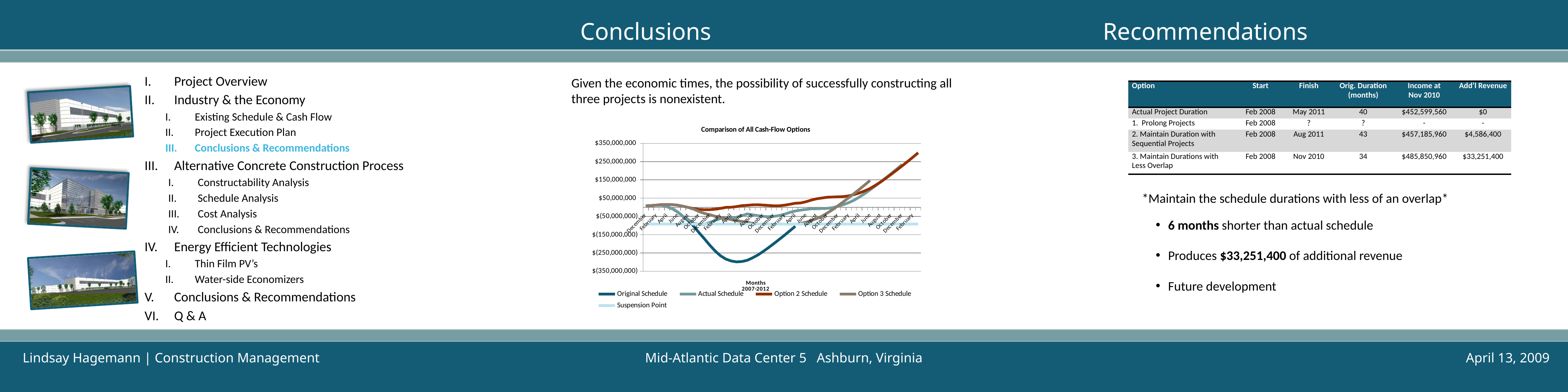
Is the final value of the Option 2 Schedule line greater or less than $250,000,000? greater What is the highest value shown on the chart's y axis? $350,000,000 Is the lowest point of the Original Schedule line greater or less than $(250,000,000)? less What is the title of the chart? Comparison of All Cash-Flow Options Is the Suspension Point line greater or less than $(150,000,000)? greater Over the final months on the x axis, does the Option 2 Schedule line rise or fall? rise What type of chart is shown on the slide? line chart Which series reaches the lowest value on the chart? Original Schedule What is the x-axis title of the chart? Months 2007-2012 How many series does the chart's legend list? 5 At the end of the x axis, which is larger: Option 2 Schedule or Original Schedule? Option 2 Schedule Which series reaches the highest value on the chart? Option 2 Schedule